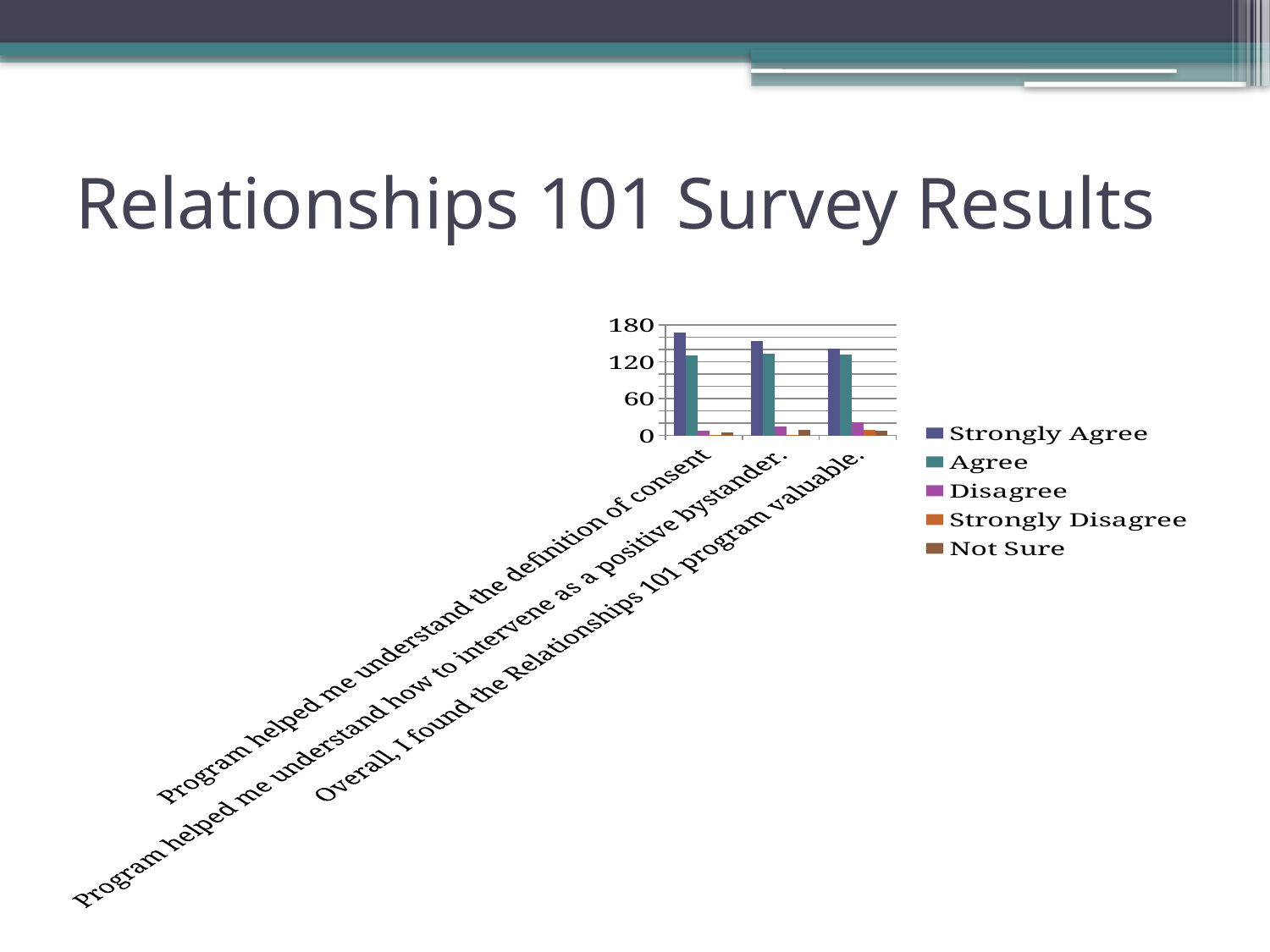
Is the Strongly Agree value for "Program helped me understand how to intervene as a positive bystander." greater or less than 120? greater What is the title of the slide containing the chart? Relationships 101 Survey Results What kind of chart is shown on the slide? bar chart How many survey statements (categories) are plotted on the x axis? 3 Do the Strongly Agree values rise or fall moving left to right across the three statements? fall How many series does the legend list? 5 Is the Strongly Agree value for "Program helped me understand the definition of consent" greater or less than 120? greater Is the Disagree value for "Overall, I found the Relationships 101 program valuable." greater or less than 60? less Which survey statement has the highest Strongly Agree value? Program helped me understand the definition of consent Which series is listed last in the legend? Not Sure For "Program helped me understand how to intervene as a positive bystander.", which is larger: Strongly Agree or Disagree? Strongly Agree For "Program helped me understand the definition of consent", which is larger: Strongly Agree or Agree? Strongly Agree